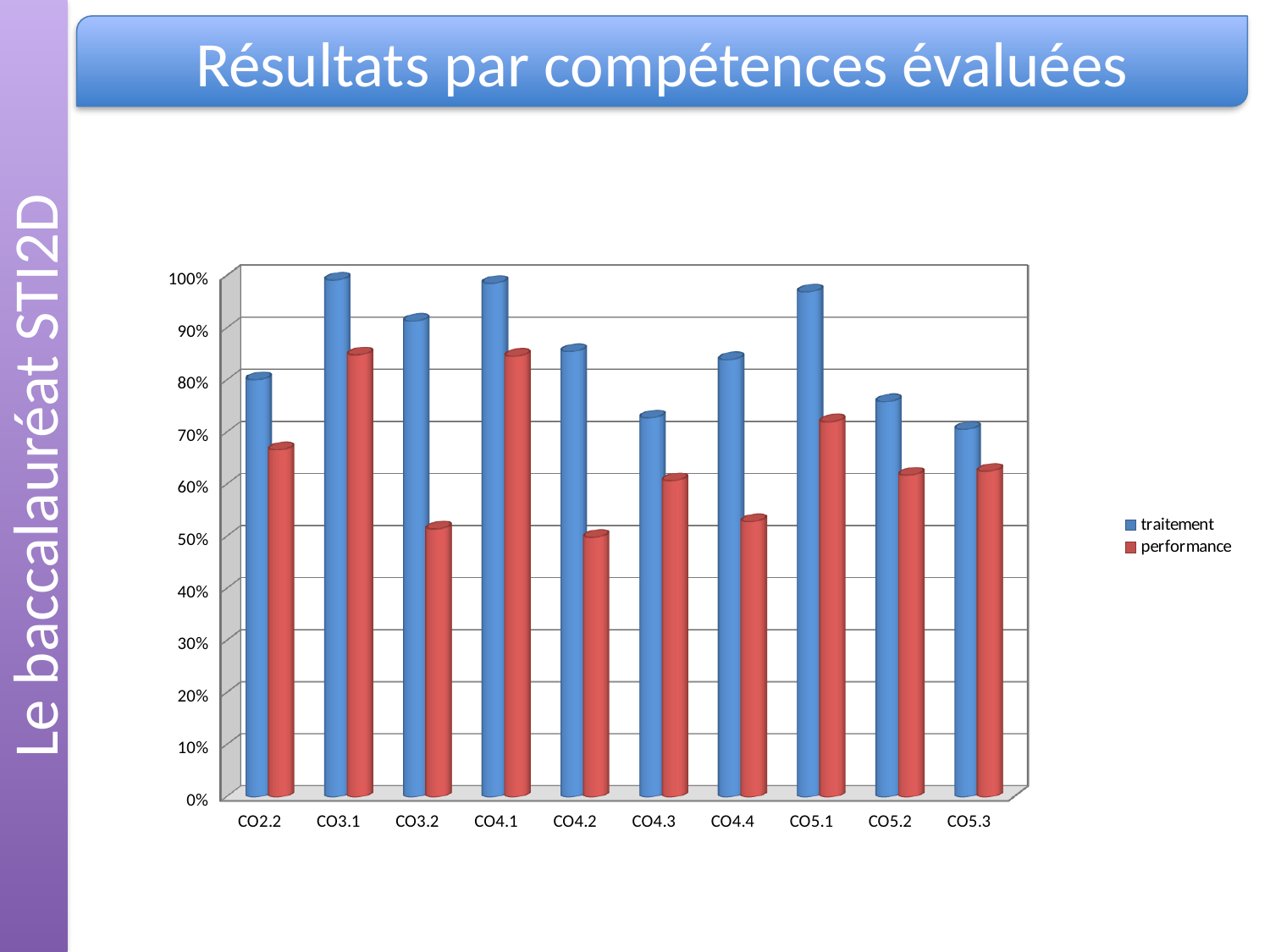
Is the traitement value for CO2.2 greater or less than 70%? greater What colour are the bars for the performance series? red Which is larger, the performance value for CO3.1 or for CO4.2? CO3.1 What kind of chart is shown on the slide? bar chart Is the performance value for CO5.1 greater or less than 60%? greater Is the performance value for CO4.2 greater or less than 60%? less How many series does the chart's legend list? 2 Which is larger, the traitement value for CO3.1 or for CO4.3? CO3.1 How many categories are shown along the x axis of the chart? 10 For CO3.2, which series has the larger value, traitement or performance? traitement